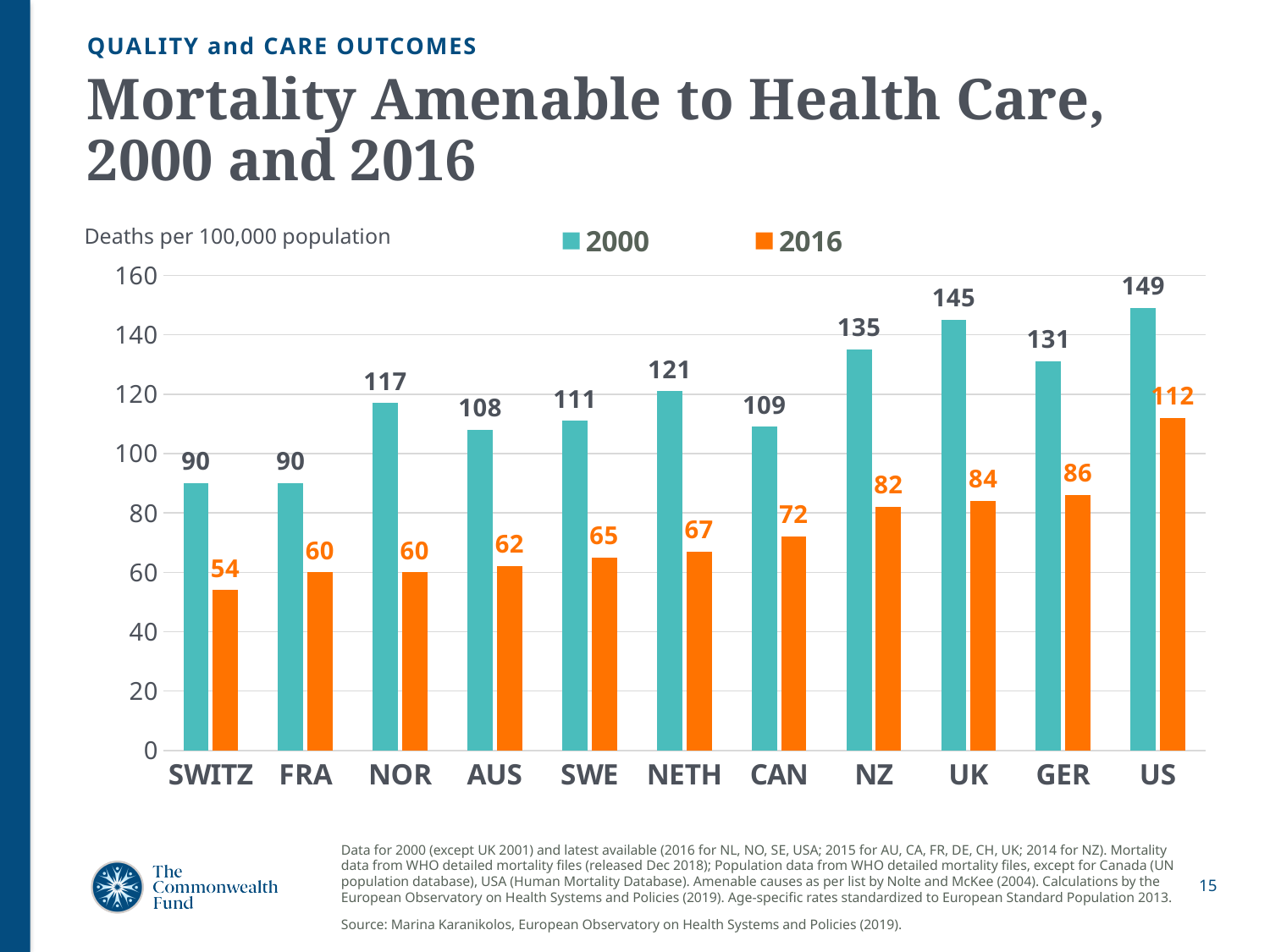
What is the difference between the 2000 values for the US and SWITZ? 59 What unit is the y axis measured in, according to the label above the chart? Deaths per 100,000 population What is the difference between the 2000 and 2016 values for the UK? 61 How many countries are shown on the x axis? 11 How many series does the legend list? 2 Which country had the lowest value in 2016? SWITZ What was the value for the US in 2016? 112 What kind of chart is shown on the slide? Bar chart Which country had the highest value in 2000? US What was the value for NOR in 2000? 117 Which is larger: the 2016 value for CAN or the 2016 value for NZ? NZ Which colour represents the 2016 series in the legend? Orange